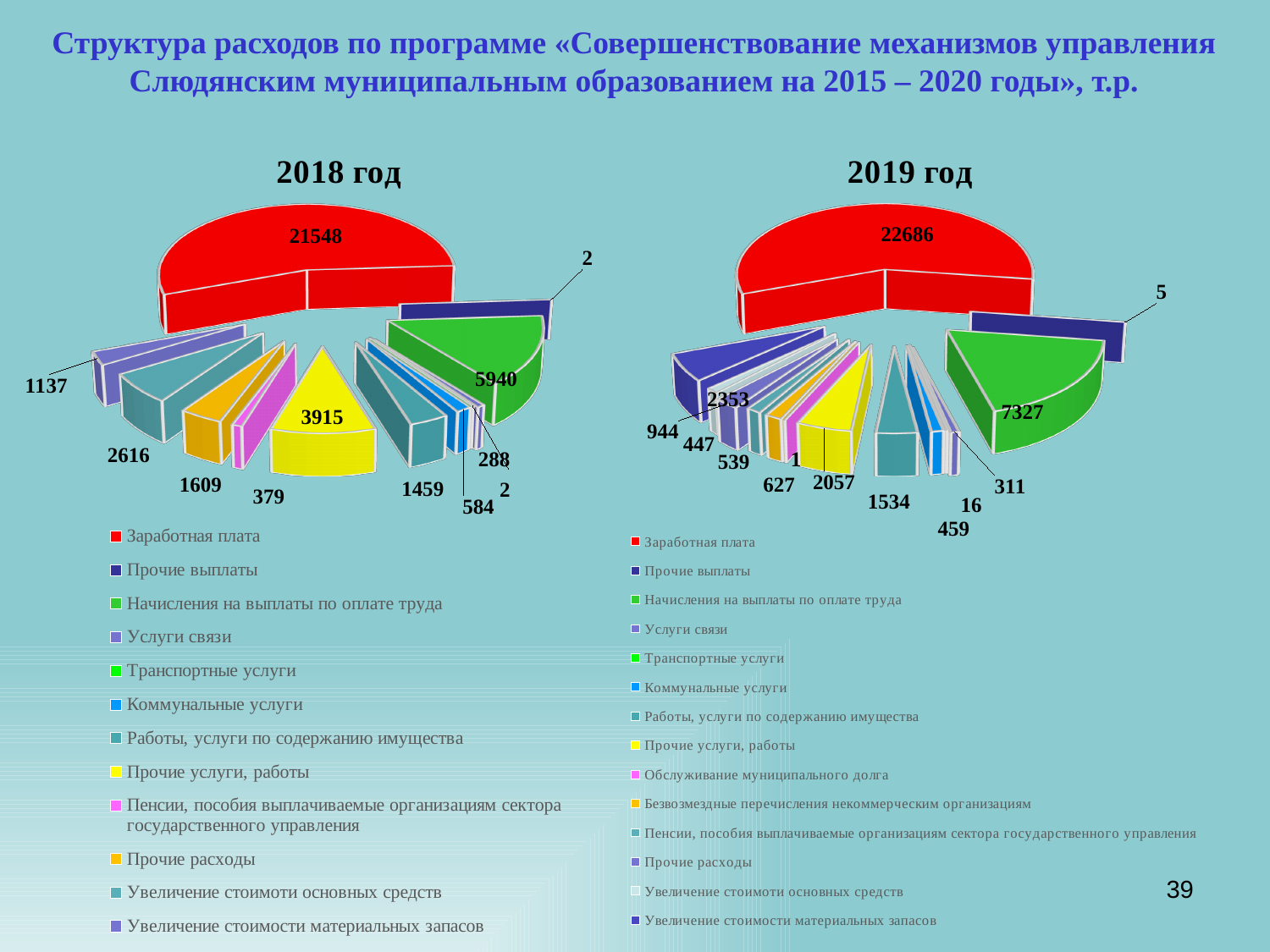
Which is larger: Заработная плата in the 2018 год chart or in the 2019 год chart? 2019 год In the 2018 год chart, what is the value for Начисления на выплаты по оплате труда? 5940 What is the difference between the Начисления на выплаты по оплате труда values in the 2019 год chart and the 2018 год chart? 1387 How many categories does the legend of the 2019 год chart list? 14 In the 2018 год chart, what is the value for Заработная плата? 21548 In the 2019 год chart, which category has the largest slice? Заработная плата In the 2019 год chart, what is the value for Прочие выплаты? 5 In the 2019 год chart, what is the value for Заработная плата? 22686 In the 2019 год chart, what is the value for Начисления на выплаты по оплате труда? 7327 What kind of chart is used for the 2018 год data? pie chart What is the difference between the Заработная плата values in the 2019 год chart and the 2018 год chart? 1138 In the 2018 год chart, what is the value for Прочие выплаты? 2